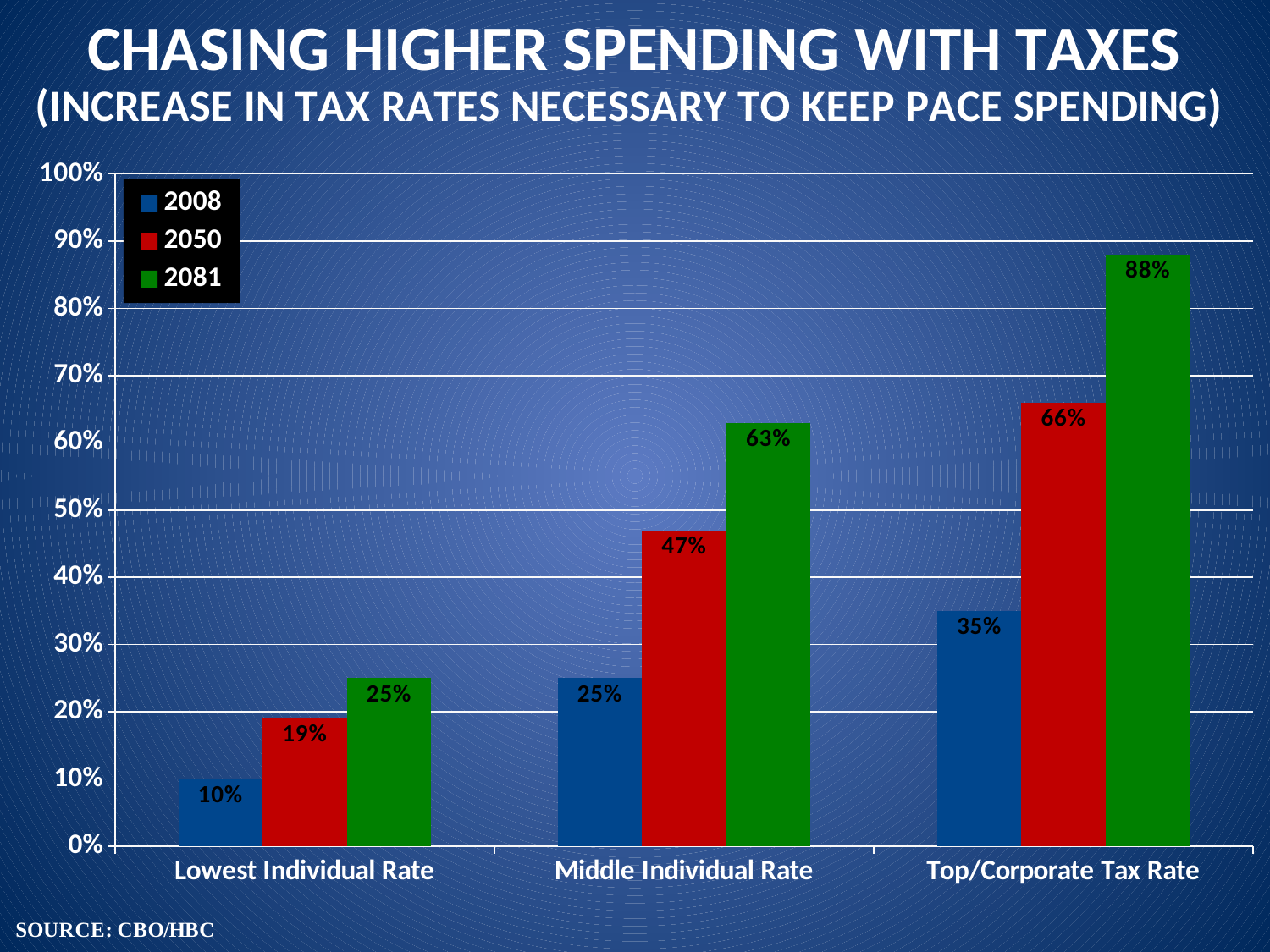
What is the value for 2081 in the Top/Corporate Tax Rate category? 88% Which category has the lowest value for 2008? Lowest Individual Rate How many series does the legend list? 3 Which is larger: the 2050 value for Middle Individual Rate or the 2008 value for Top/Corporate Tax Rate? 2050 value for Middle Individual Rate What kind of chart is shown on the slide? Bar chart What is the value for 2050 in the Middle Individual Rate category? 47% What is the difference between the 2081 and 2008 values for the Middle Individual Rate? 38% Which colour represents the 2050 series? Red What is the value for 2008 in the Lowest Individual Rate category? 10% What is the difference between the 2050 values for Top/Corporate Tax Rate and Lowest Individual Rate? 47% How many categories are shown on the x axis? 3 Which category has the highest value for 2081? Top/Corporate Tax Rate